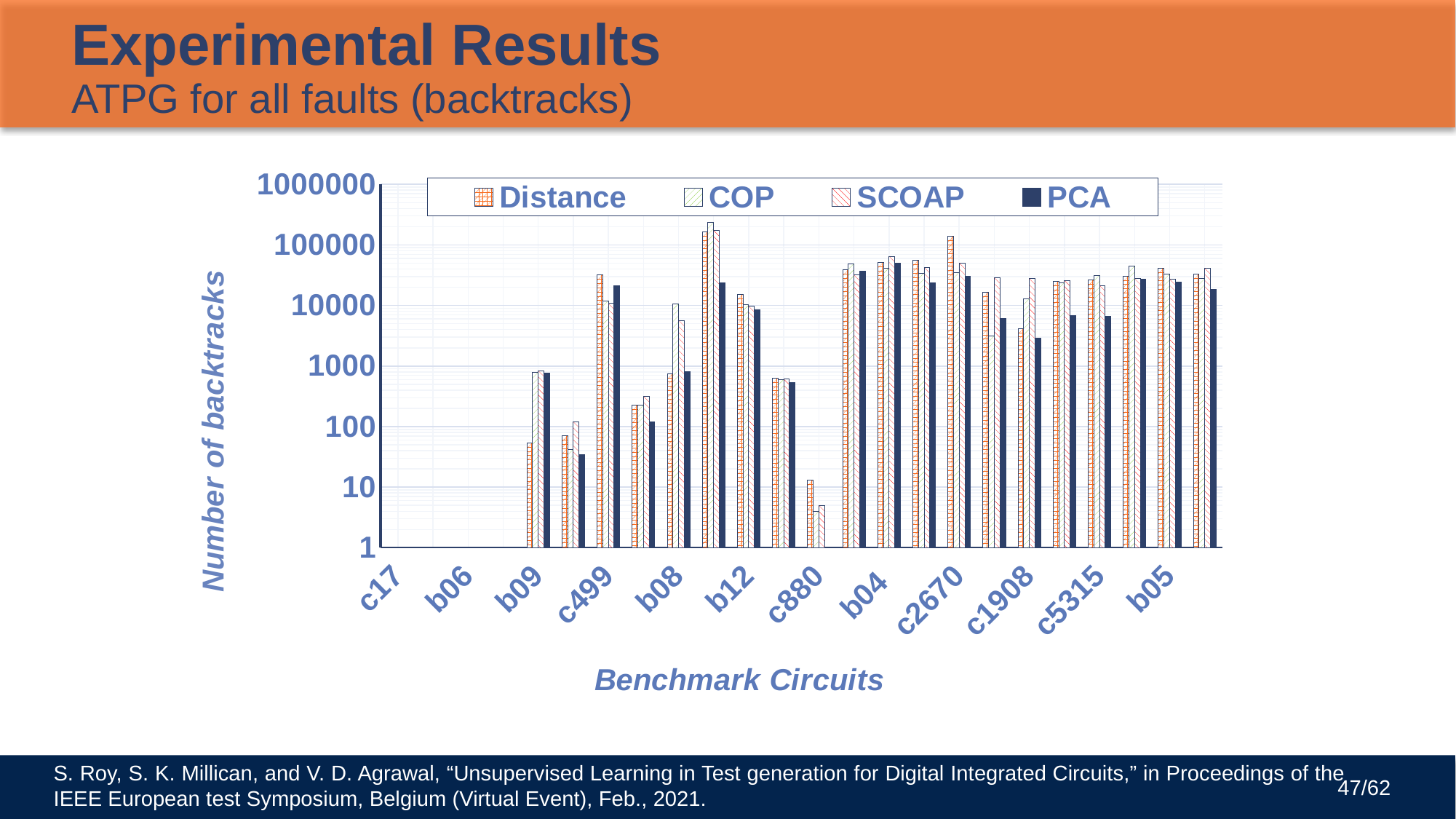
Is the SCOAP value for c1908 greater or less than 10000? greater Is the Distance value for b09 greater or less than 100? less Which series has the tallest bar anywhere in the chart? COP Is the Distance value for c2670 greater or less than 100000? greater How many series does the legend list? 4 For c2670, which is larger, the Distance value or the PCA value? Distance What kind of chart is shown on the slide? bar chart What is the title of the horizontal axis? Benchmark Circuits What is the title of the vertical axis? Number of backtracks